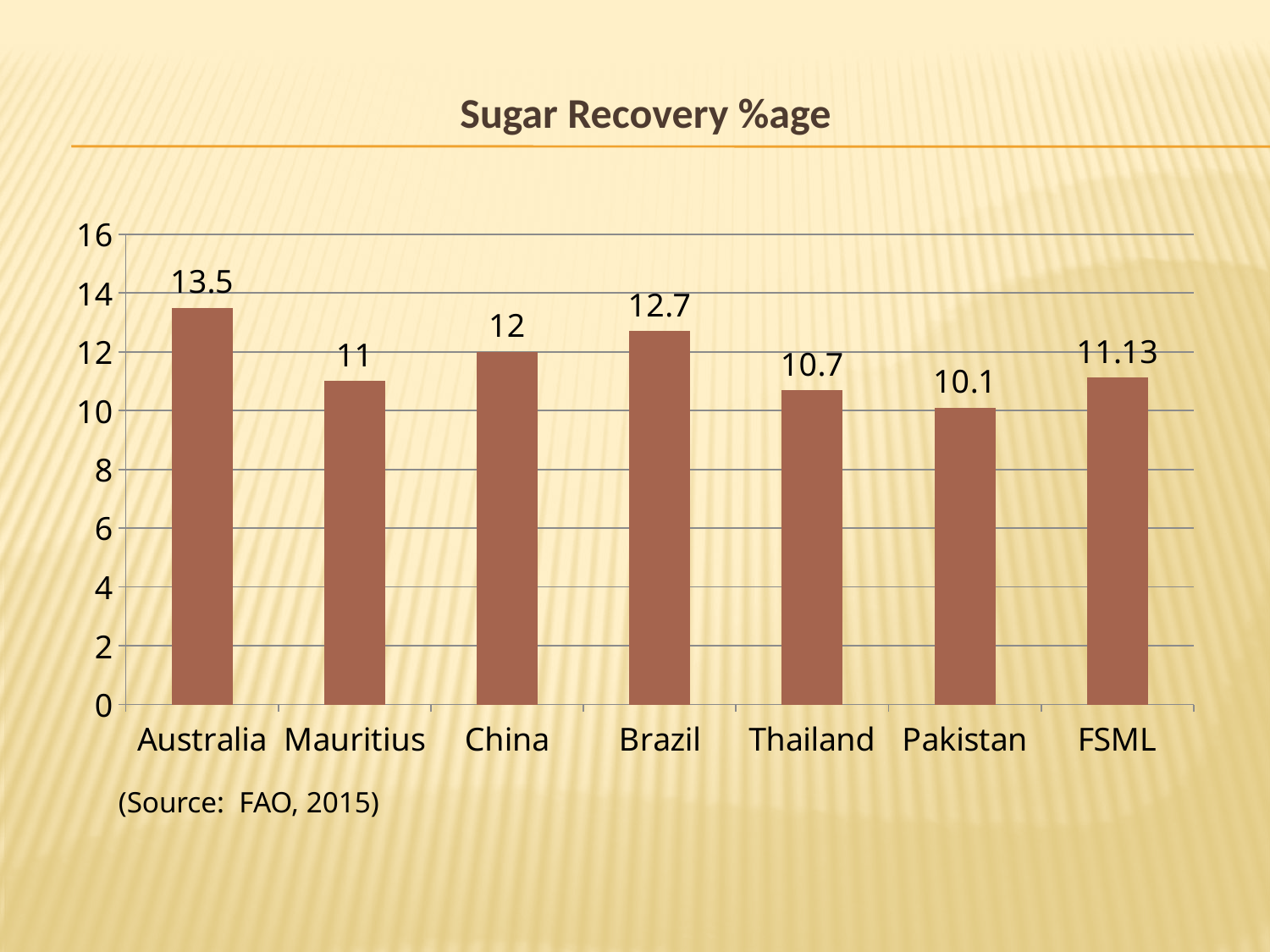
What type of chart is shown on the slide? Bar chart Which country has the highest sugar recovery percentage? Australia Which has a higher sugar recovery percentage, Mauritius or Brazil? Brazil How many categories are shown in the chart? 7 Is the value for China greater or less than 10? greater What is the difference between the sugar recovery percentages of Australia and Pakistan? 3.4 What is the difference between the sugar recovery percentages of Brazil and China? 0.7 What is the sugar recovery percentage for Australia? 13.5 What is the title of the chart? Sugar Recovery %age What is the sugar recovery percentage for FSML? 11.13 What is the sugar recovery percentage for Thailand? 10.7 Which category has the lowest sugar recovery percentage? Pakistan